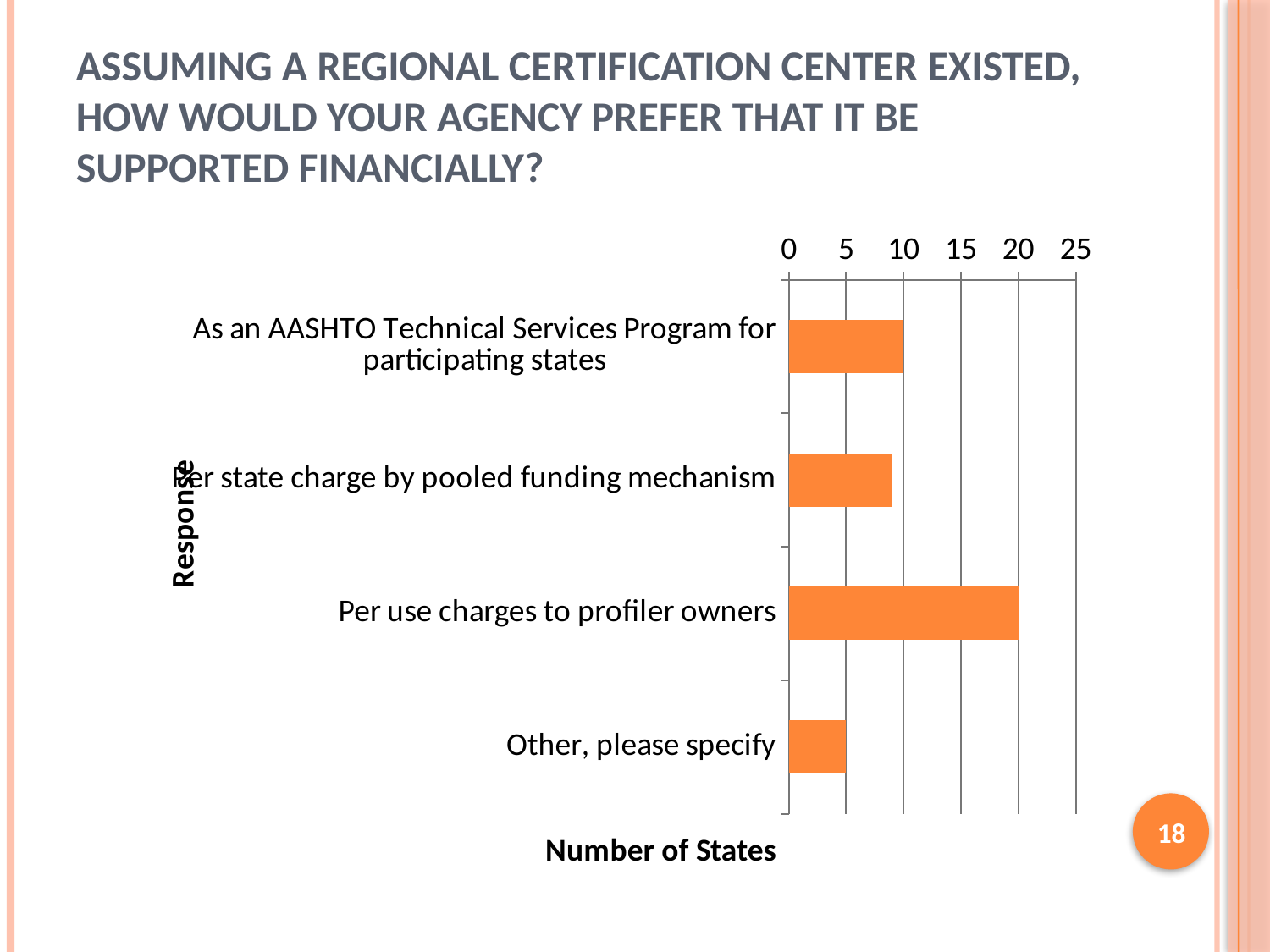
How many states chose 'As an AASHTO Technical Services Program for participating states'? 10 Which response has the lowest number of states? Other, please specify How many states chose 'Per use charges to profiler owners'? 20 How many response categories are plotted in the chart? 4 What is the title of the horizontal axis of the chart? Number of States Is the value for 'Per state charge by pooled funding mechanism' greater or less than 5? greater What is the difference between the number of states for 'Per use charges to profiler owners' and 'Other, please specify'? 15 Which has more states: 'Per use charges to profiler owners' or 'As an AASHTO Technical Services Program for participating states'? Per use charges to profiler owners How many states chose 'Other, please specify'? 5 Is the value for 'Per state charge by pooled funding mechanism' greater or less than 10? less What kind of chart is shown on the slide? bar chart Which response has the highest number of states? Per use charges to profiler owners